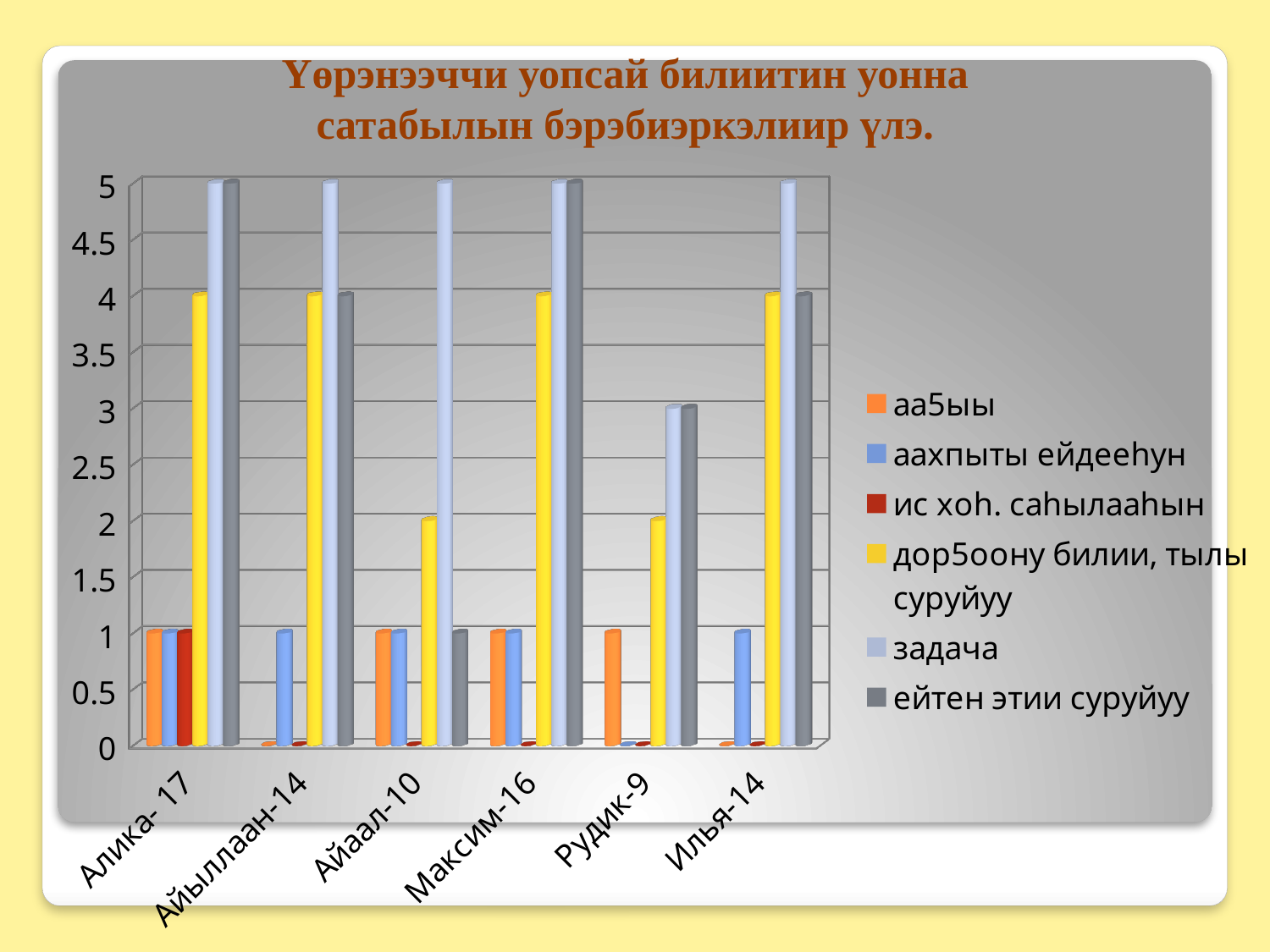
What is the value of 'задача' for Рудик-9? 3 What is the value of 'дор5оону билии, тылы суруйуу' for Айаал-10? 2 Which series is shown in yellow in the legend? дор5оону билии, тылы суруйуу Which category has the lowest value for 'задача'? Рудик-9 What is the value of 'ейтен этии суруйуу' for Айаал-10? 1 Which category has the lowest value for 'ейтен этии суруйуу'? Айаал-10 Is the value of 'ейтен этии суруйуу' for Максим-16 greater or less than 3? greater What is the difference between 'задача' for Алика-17 and 'задача' for Рудик-9? 2 Is the value of 'дор5оону билии, тылы суруйуу' for Алика-17 larger or smaller than for Рудик-9? larger How many series does the legend list? 6 How many categories (students) are shown on the x axis? 6 What kind of chart is shown on the slide? bar chart